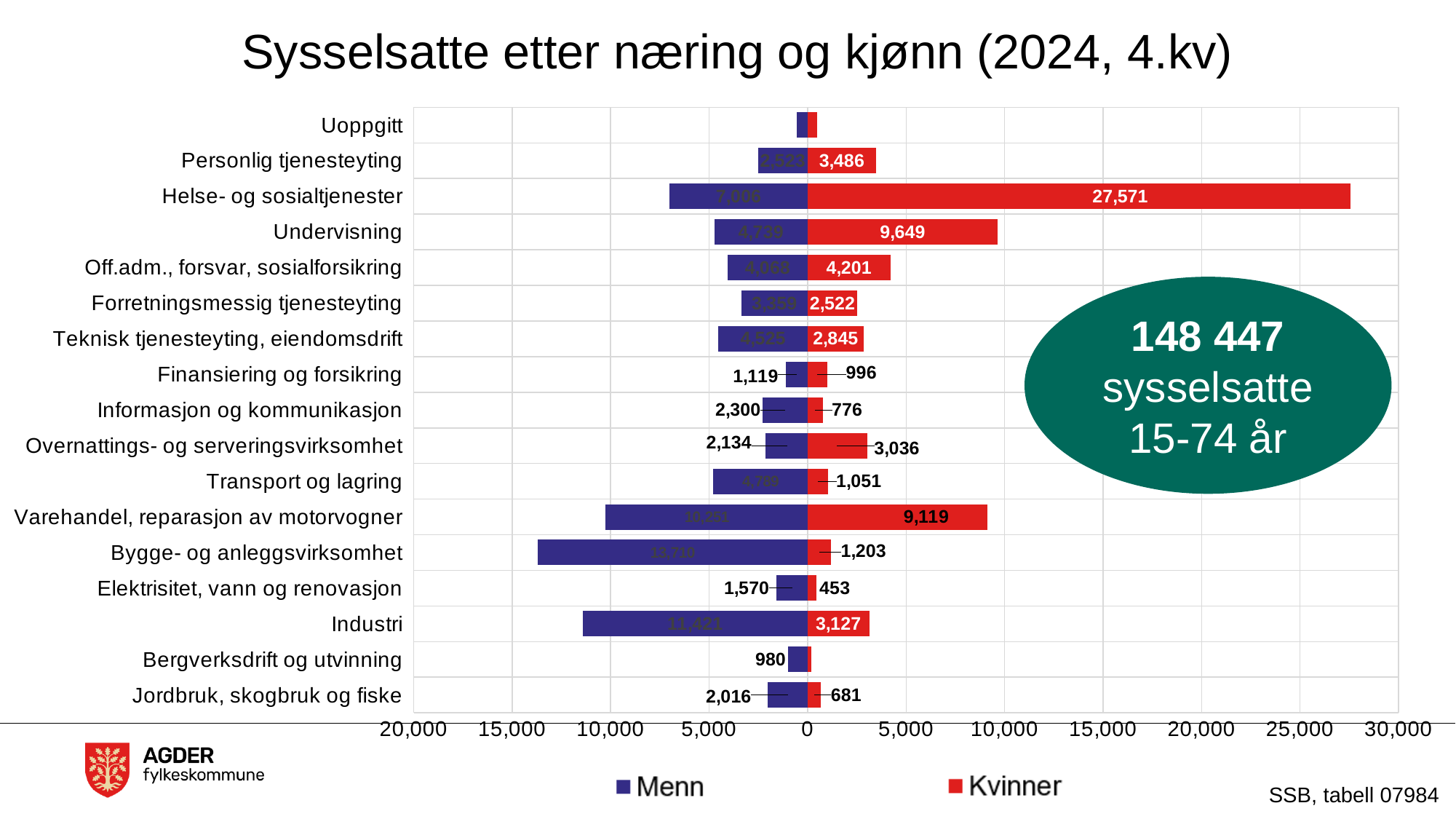
Which industry has the highest value for Kvinner? Helse- og sosialtjenester How many series does the legend list? 2 Which industry has the highest value for Menn? Bygge- og anleggsvirksomhet What is the difference between the Menn and Kvinner values for Jordbruk, skogbruk og fiske? 1,335 In Overnattings- og serveringsvirksomhet, which series has the larger value, Menn or Kvinner? Kvinner What is the value for Kvinner in Undervisning? 9,649 What is the difference between the Kvinner values for Undervisning and Varehandel, reparasjon av motorvogner? 530 What is the value for Menn in Informasjon og kommunikasjon? 2,300 Is the value for Menn in Bygge- og anleggsvirksomhet greater or less than 10,000? greater How many women (Kvinner) are employed in Helse- og sosialtjenester? 27,571 How many industry categories are shown on the chart? 17 What is the value for Menn in Bergverksdrift og utvinning? 980